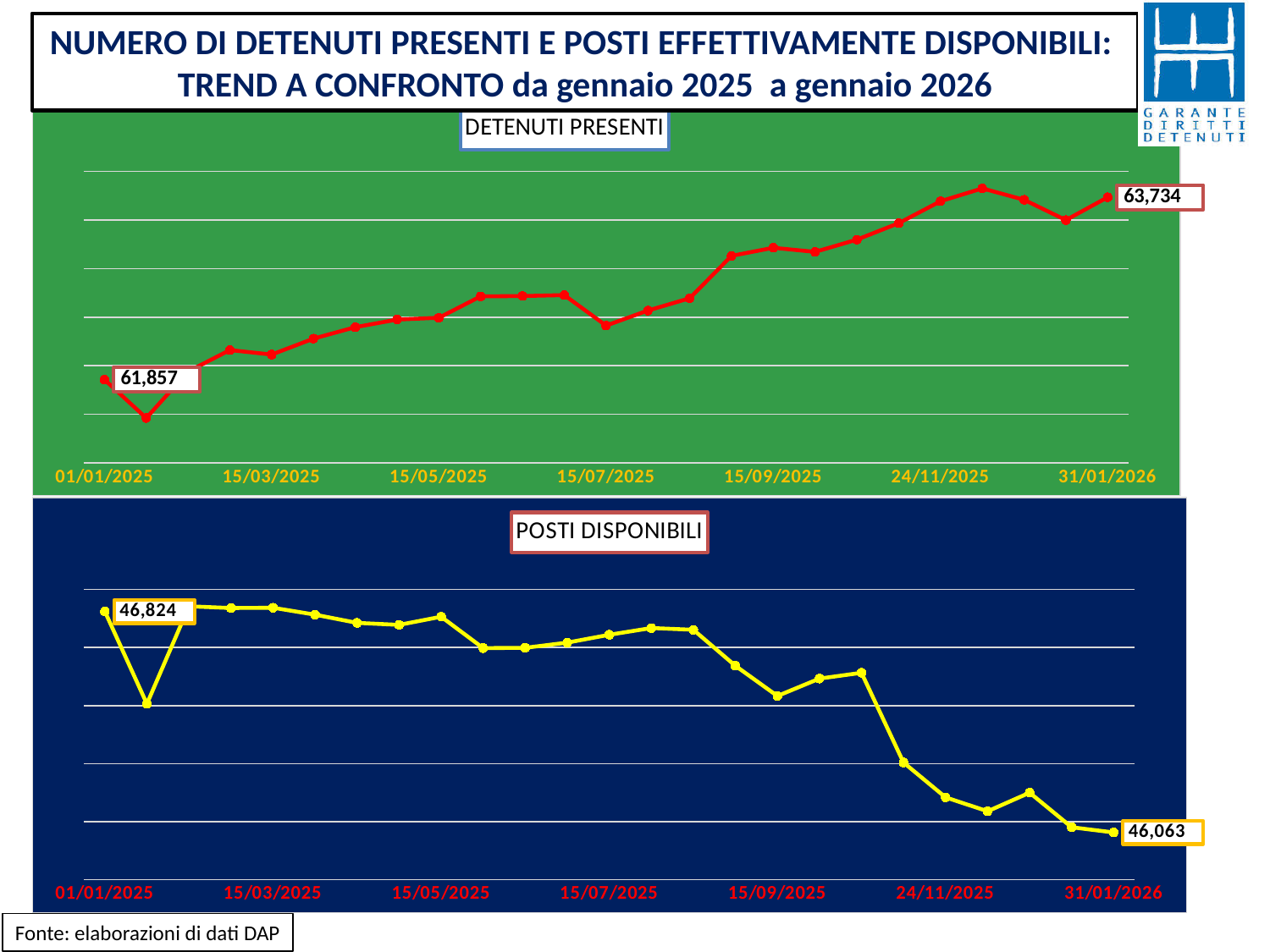
In the POSTI DISPONIBILI chart, which is larger: the value at 01/01/2025 or the value at 31/01/2026? 01/01/2025 In the POSTI DISPONIBILI chart, what is the value labelled at 01/01/2025? 46,824 What colour is the line in the POSTI DISPONIBILI chart? yellow In the DETENUTI PRESENTI chart, what is the value labelled at 01/01/2025? 61,857 What kind of chart is the DETENUTI PRESENTI chart? line chart In the DETENUTI PRESENTI chart, what is the value labelled at 31/01/2026? 63,734 In the POSTI DISPONIBILI chart, what is the value labelled at 31/01/2026? 46,063 In the DETENUTI PRESENTI chart, do the values generally rise or fall from 01/01/2025 to 31/01/2026? rise In the POSTI DISPONIBILI chart, do the values generally rise or fall from 01/01/2025 to 31/01/2026? fall In the POSTI DISPONIBILI chart, what is the difference between the value at 01/01/2025 and the value at 31/01/2026? 761 In the DETENUTI PRESENTI chart, which is larger: the value at 01/01/2025 or the value at 31/01/2026? 31/01/2026 In the DETENUTI PRESENTI chart, what is the difference between the value at 31/01/2026 and the value at 01/01/2025? 1,877